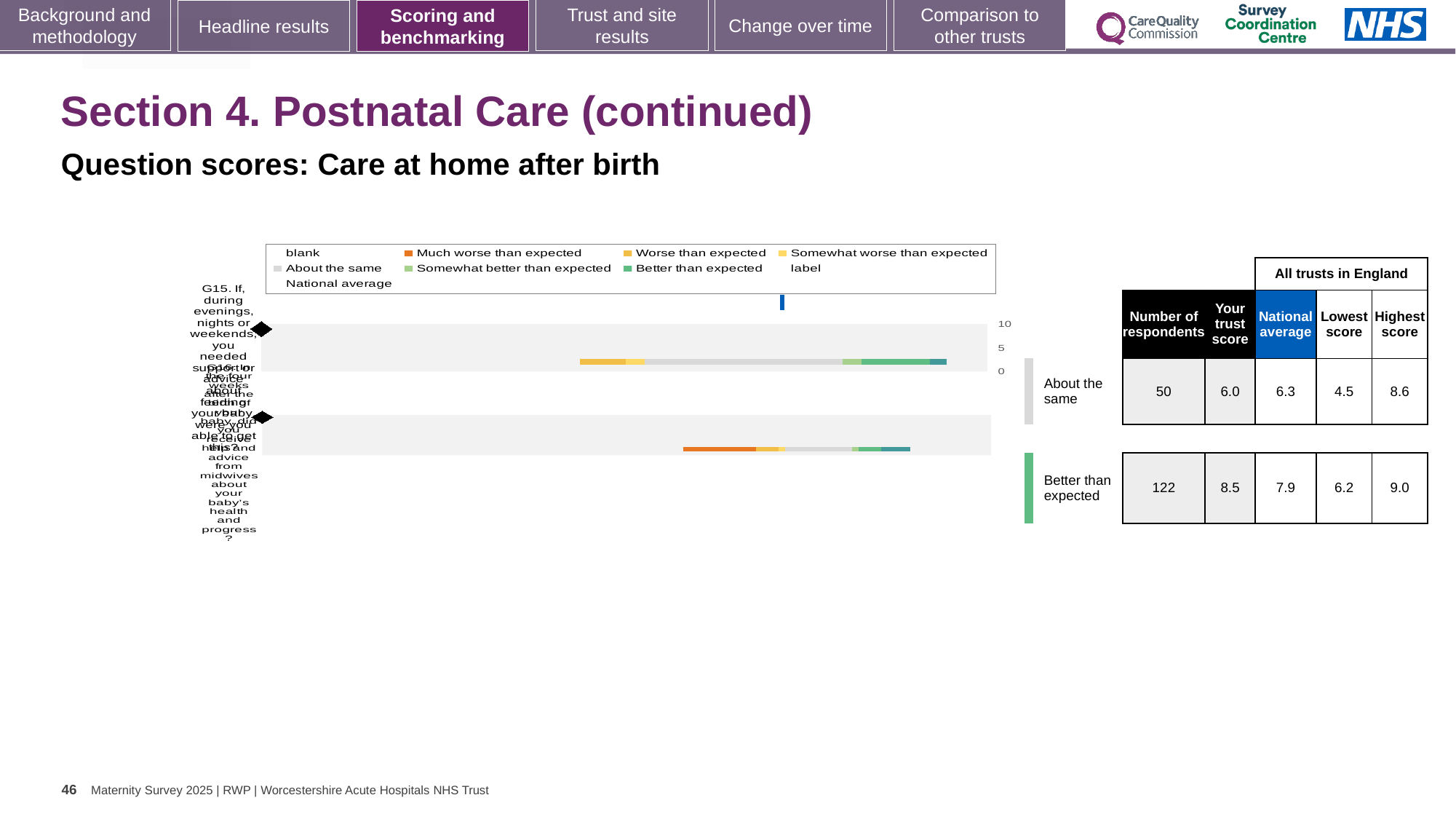
In the table, what is the highest score among all trusts in England for the row rated 'Better than expected'? 9.0 In the table, what is the trust score for the row rated 'Better than expected'? 8.5 What kind of chart is shown on the slide? bar chart What is the highest value shown on the chart's score axis? 10 In the table, what is the number of respondents for the row rated 'About the same'? 50 Which legend entry is shown in orange? Much worse than expected For the row rated 'Better than expected', what is the difference between the trust score and the national average? 0.6 In the table, what is the national average for the row rated 'About the same'? 6.3 In the table, what is the lowest score among all trusts in England for the row rated 'About the same'? 4.5 For the row rated 'About the same', what is the difference between the national average and the trust score? 0.3 How many survey questions (bars) are plotted in the chart? 2 For the row rated 'Better than expected', which is larger: the trust score or the national average? trust score